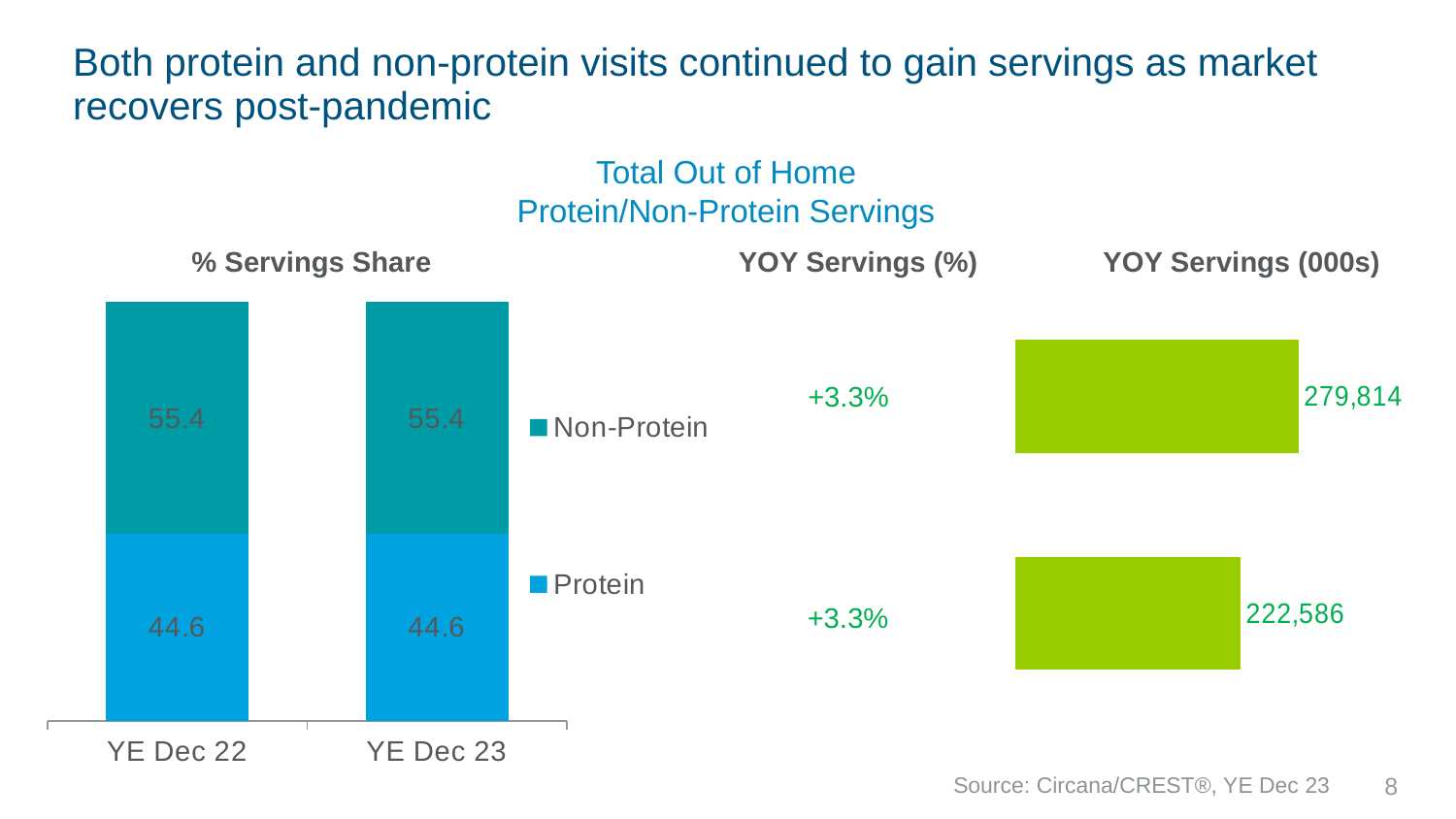
How many series does the legend of the % Servings Share chart list? 2 How many time periods are shown on the x axis of the % Servings Share chart? 2 What kind of chart is the % Servings Share chart? Stacked bar chart In the % Servings Share chart, what is the total of the stacked bar for YE Dec 22? 100 In the % Servings Share chart, what is the Non-Protein share for YE Dec 23? 55.4 In the % Servings Share chart, which series has the larger share in YE Dec 22, Non-Protein or Protein? Non-Protein In the YOY Servings (000s) chart, what is the value for Protein? 222,586 In the % Servings Share chart, what is the difference between the Non-Protein and Protein shares in YE Dec 23? 10.8 In the % Servings Share chart, what is the Protein share for YE Dec 22? 44.6 In the YOY Servings (000s) chart, what is the difference between the Non-Protein and Protein values? 57,228 What is the YOY Servings (%) change shown for Protein? +3.3% In the YOY Servings (000s) chart, what is the value for Non-Protein? 279,814